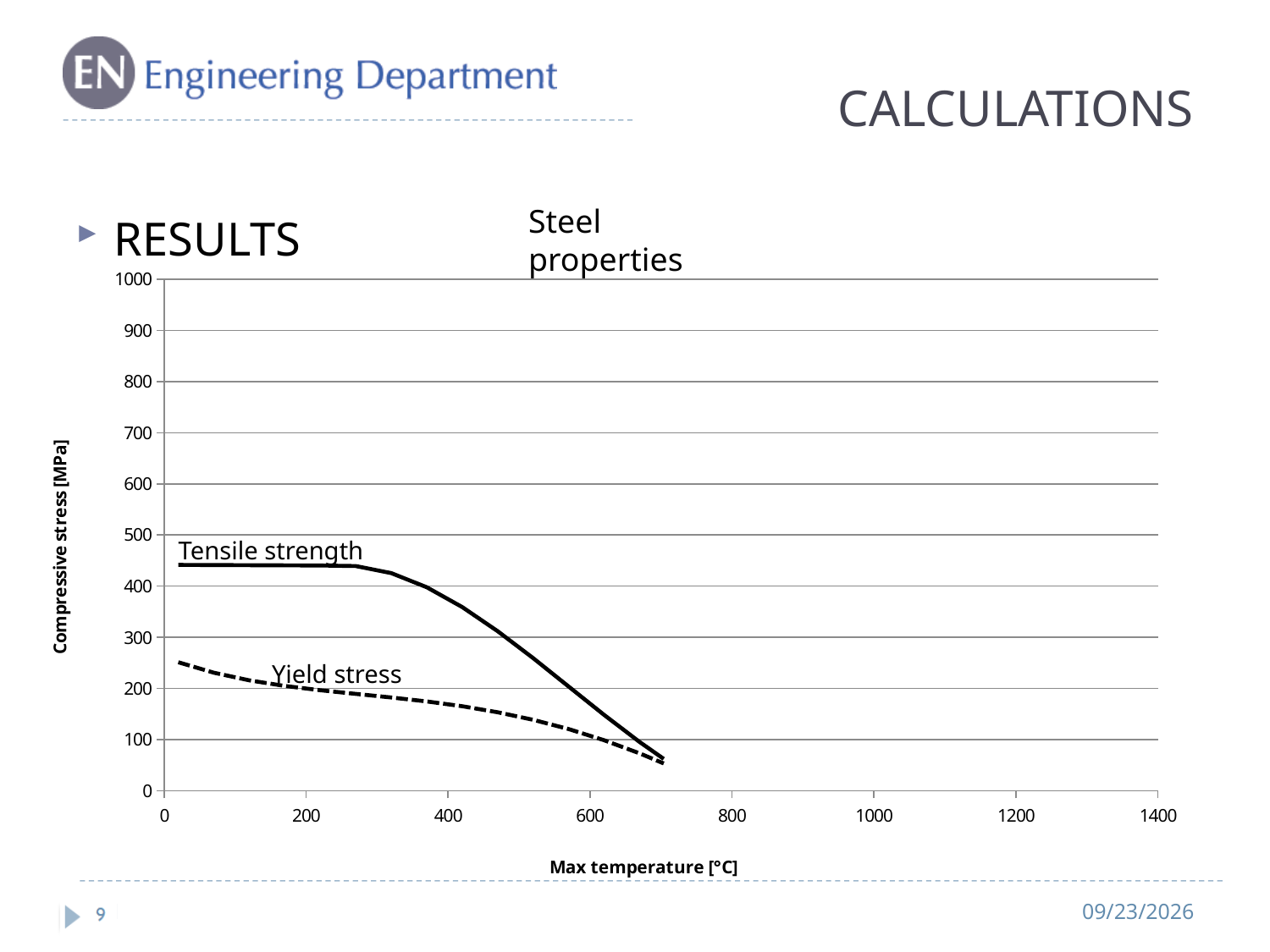
Is the Tensile strength value at 400 °C greater or less than 300? greater Which series has the higher value at 100 °C, Tensile strength or Yield stress? Tensile strength How many series are plotted on the Steel properties chart? 2 What is the title of the chart? Steel properties Does the Yield stress curve rise or fall as Max temperature increases? fall What kind of chart is shown on the slide? line chart Is the Tensile strength value at 700 °C greater or less than 100? less At 400 °C, which series has the larger value, Tensile strength or Yield stress? Tensile strength What is the label of the y axis of the chart? Compressive stress [MPa] Is the Yield stress value at 400 °C greater or less than 200? less Does the Tensile strength curve rise or fall as Max temperature increases beyond 300 °C? fall